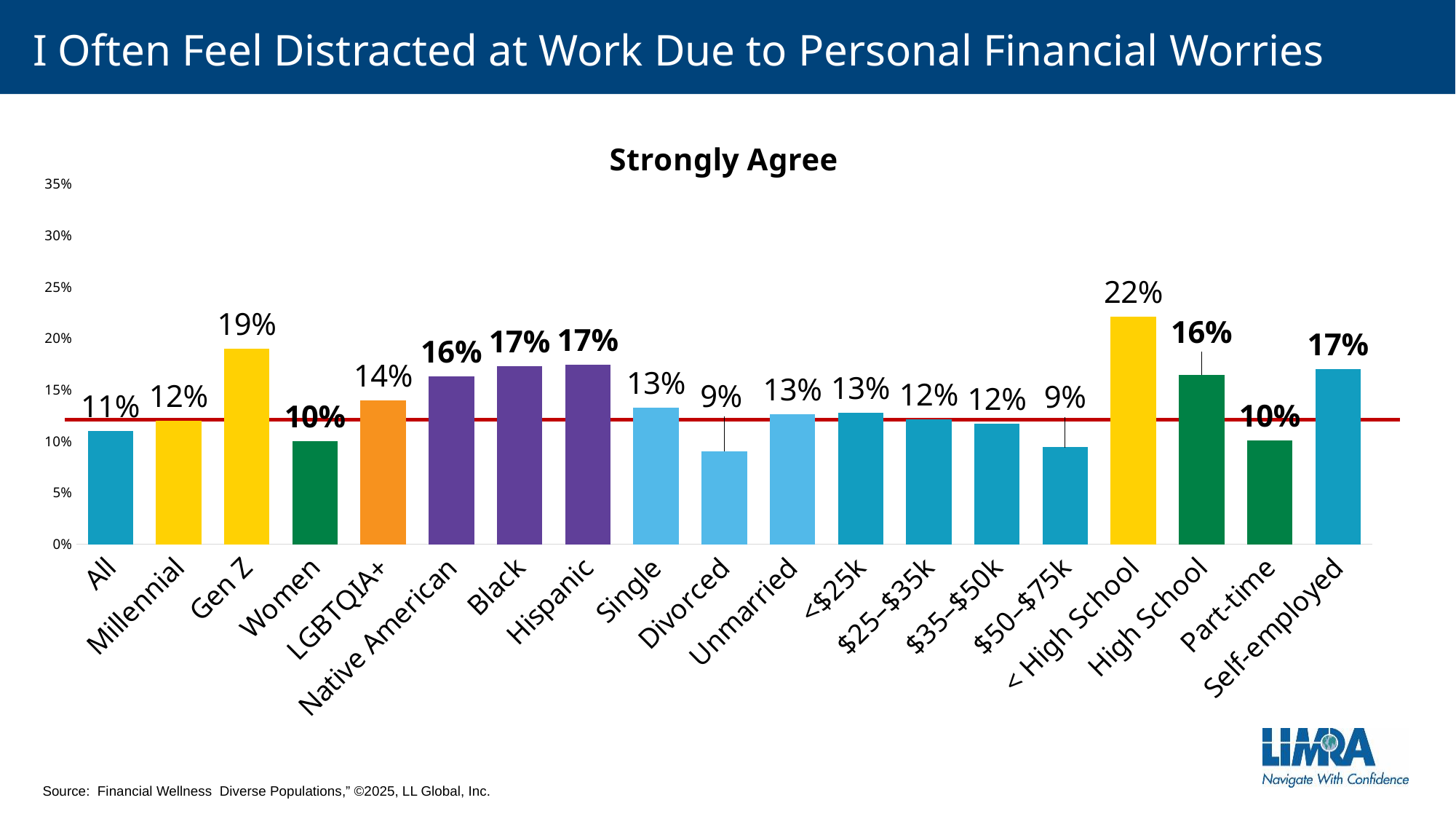
What kind of chart is shown on the slide? Bar chart How many categories are shown on the x axis? 19 What is the title shown above the chart? Strongly Agree Which is larger, the value for High School or the value for Part-time? High School Which category has the highest value? < High School What is the value for LGBTQIA+? 14% What is the difference between the values for Gen Z and Millennial? 7% What is the difference between the values for < High School and All? 11% Which is larger, the value for Women or the value for Native American? Native American What is the value for Gen Z? 19% What is the value for Divorced? 9% What is the value for Self-employed? 17%